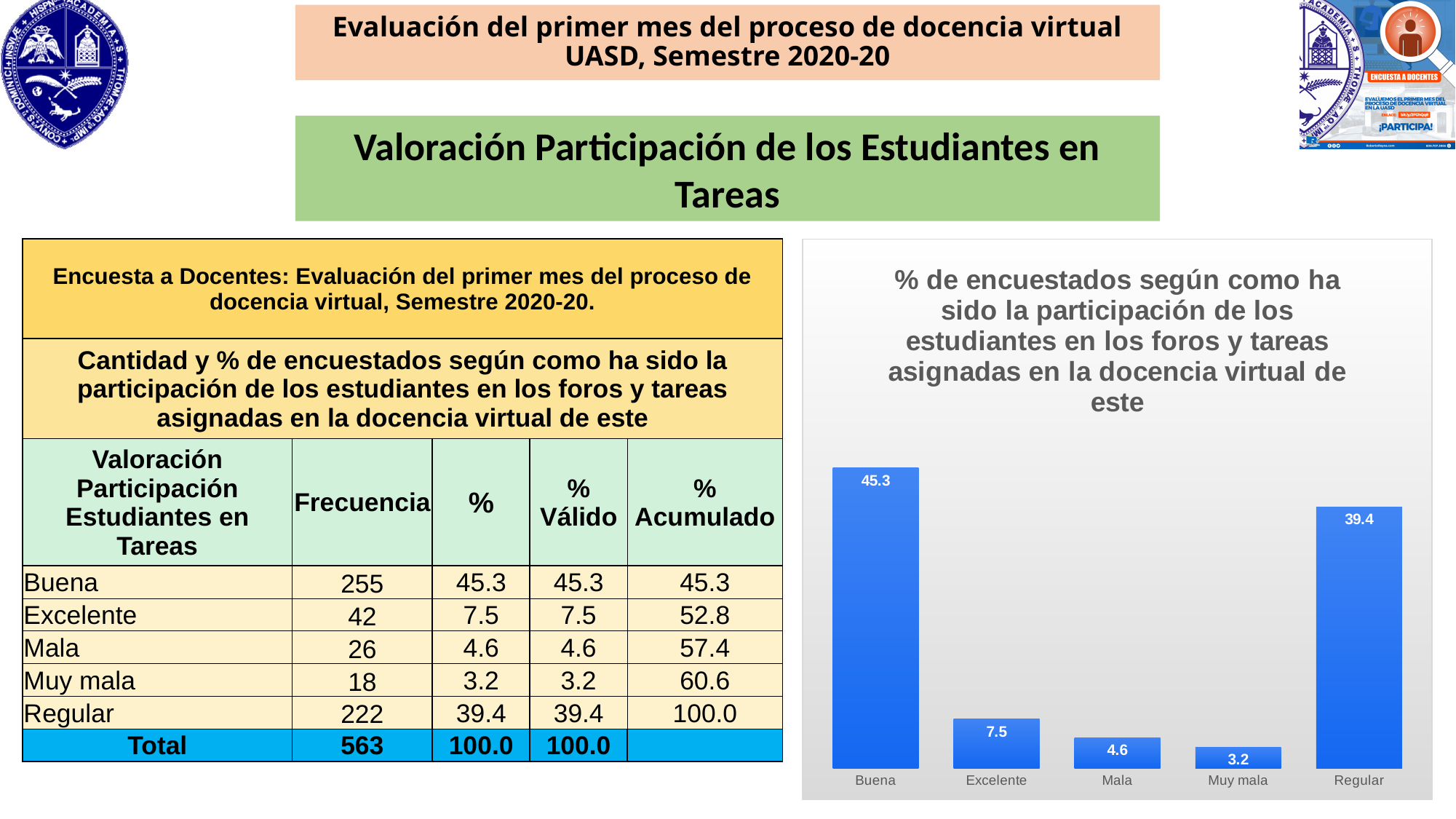
What colour are the bars in the chart? Blue Which category has the highest value in the chart? Buena What is the value shown for Muy mala in the chart? 3.2 Which is larger, the value for Mala or the value for Excelente? Excelente What is the difference between the values for Buena and Regular? 5.9 What is the value shown for Regular in the chart? 39.4 Which category has the lowest value in the chart? Muy mala What type of chart is shown on the slide? Bar chart How many categories are shown in the chart? 5 What is the value shown for Excelente in the chart? 7.5 What is the value shown for Buena in the chart? 45.3 What is the difference between the values for Excelente and Mala? 2.9